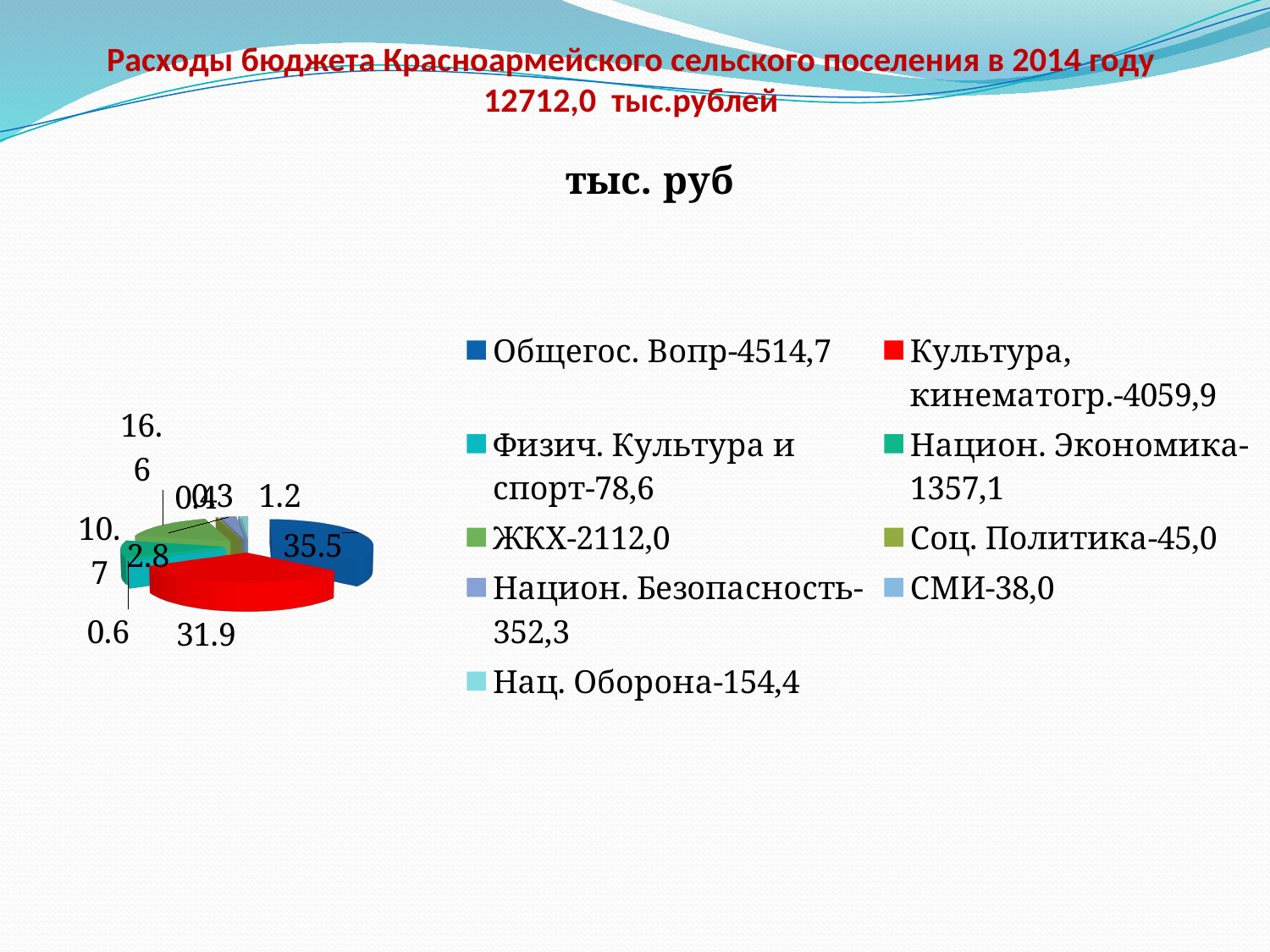
According to the legend, what is the value for ЖКХ? 2112,0 Which is larger: ЖКХ or Национ. Экономика? ЖКХ What share of the pie is labelled for the Культура, кинематогр. slice? 31.9 According to the legend, what is the value for Нац. Оборона? 154,4 What kind of chart is shown on the slide? pie chart How many categories does the pie chart's legend list? 9 What is the difference between the values for Общегос. Вопр and Культура, кинематогр.? 454,8 Which category has the largest value in the pie chart? Общегос. Вопр What share of the pie is labelled for the Общегос. Вопр slice? 35.5 Which category has the smallest value in the pie chart? СМИ What is the title of the chart? тыс. руб According to the legend, what is the value for Общегос. Вопр? 4514,7